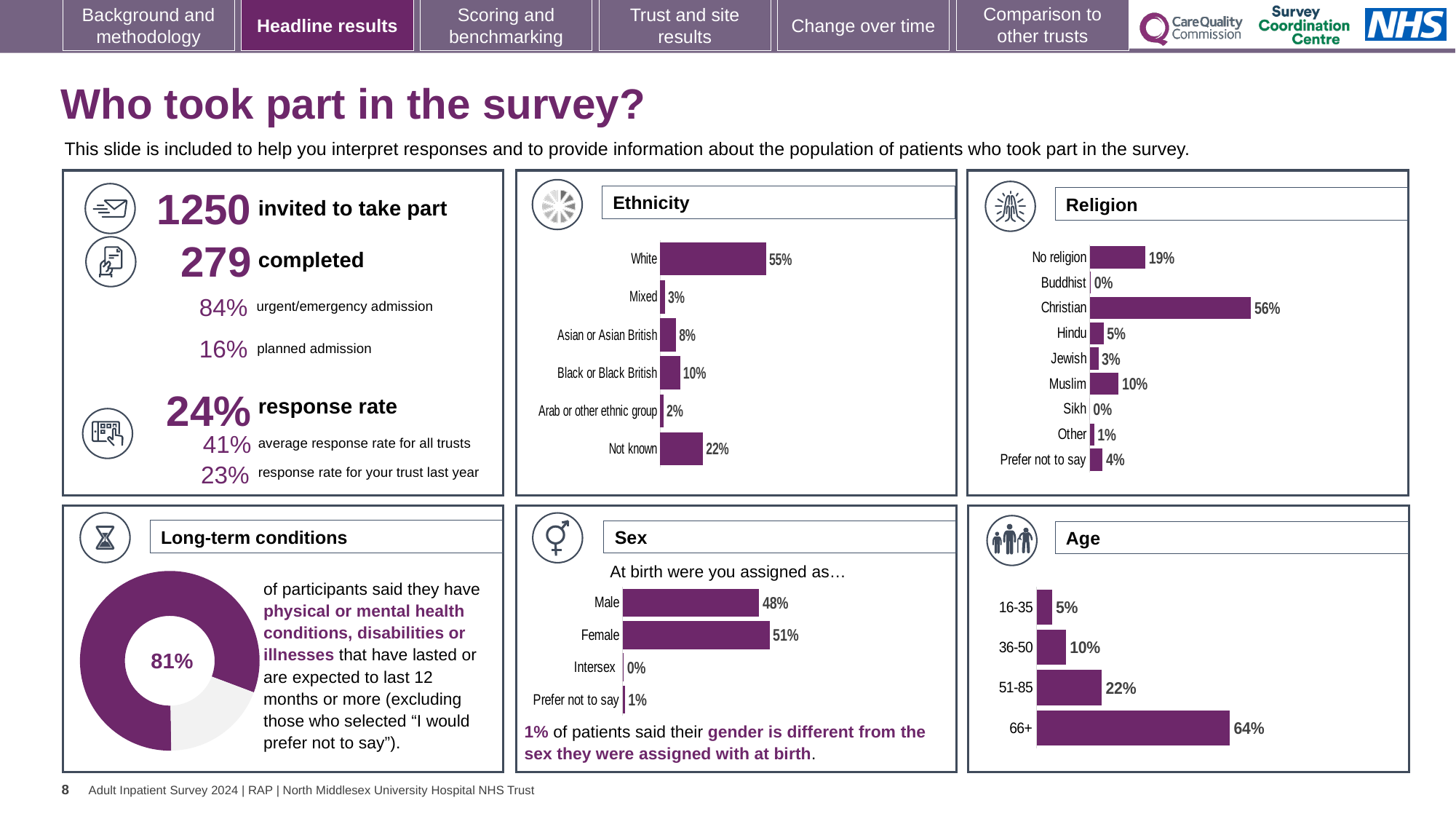
In the Age chart, do the values rise or fall as age increases from 16-35 to 66+? rise What kind of chart is used in the Long-term conditions panel? doughnut chart In the Religion chart, which category has the highest value? Christian In the Religion chart, how many categories are shown? 9 In the Sex chart, what is the difference between the Female and Male values? 3% In the Ethnicity chart, which category has the lowest value? Arab or other ethnic group In the Long-term conditions chart, what share of participants said they have a long-term condition? 81% In the Ethnicity chart, what is the difference between the Not known and Black or Black British values? 12% In the Sex chart, which is larger, Male or Female? Female In the Age chart, what percentage of participants were aged 66+? 64% In the Ethnicity chart, what percentage of participants were White? 55% In the Religion chart, what percentage of participants were Muslim? 10%